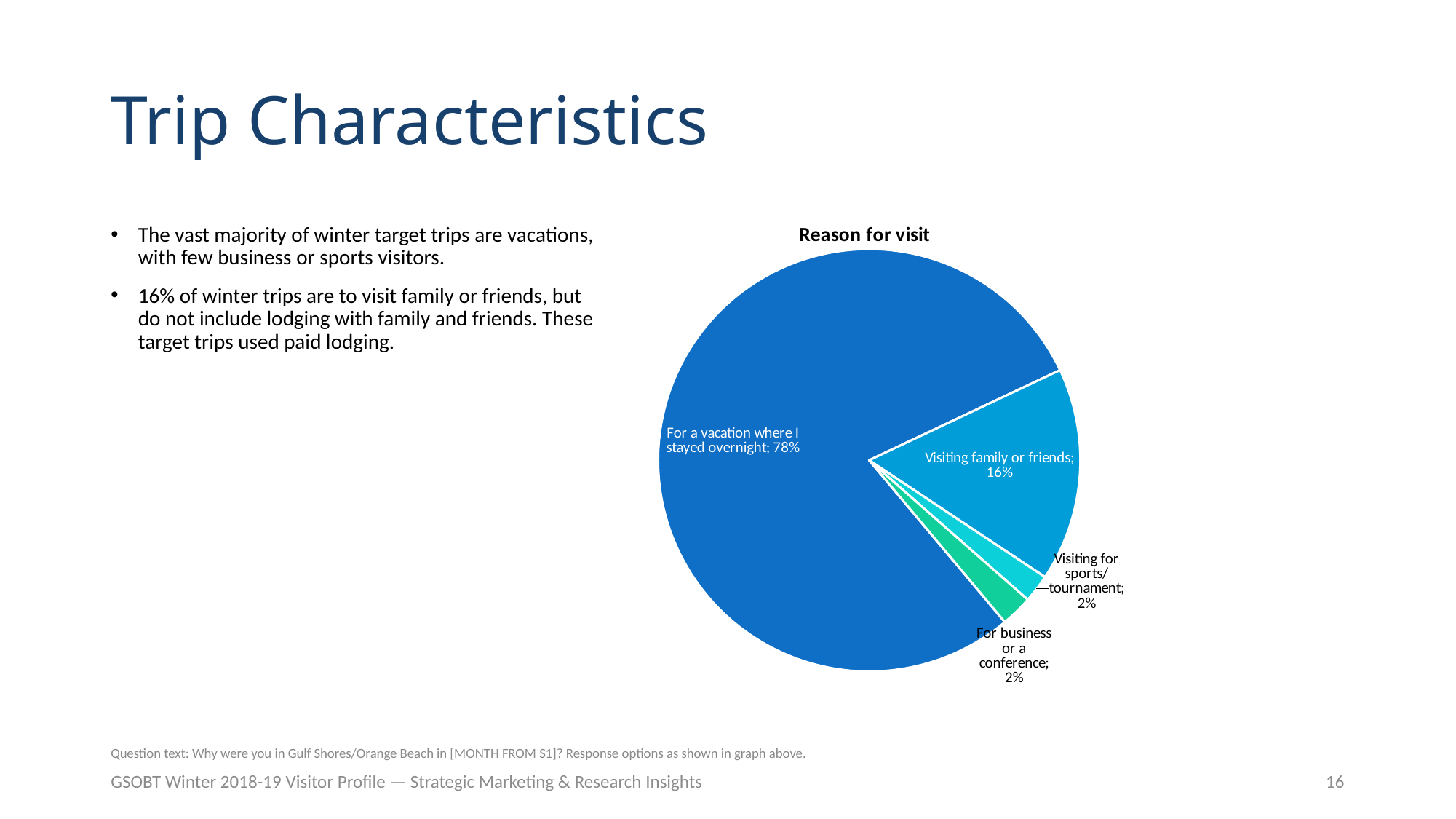
How many slices does the pie chart have? 4 What is the value for 'For business or a conference'? 2% Which is larger, 'Visiting family or friends' or 'For business or a conference'? Visiting family or friends What share of the pie is 'Visiting family or friends'? 16% What is the value for 'Visiting for sports/tournament'? 2% Is the share for 'Visiting family or friends' greater or less than 50%? less Which reason for visit has the largest slice? For a vacation where I stayed overnight What is the difference between the 'For a vacation where I stayed overnight' and 'Visiting family or friends' slices? 62 percentage points What kind of chart is shown on the slide? Pie chart What share of the pie is 'For a vacation where I stayed overnight'? 78% What is the title of the chart? Reason for visit What is the combined share of 'Visiting for sports/tournament' and 'For business or a conference'? 4%